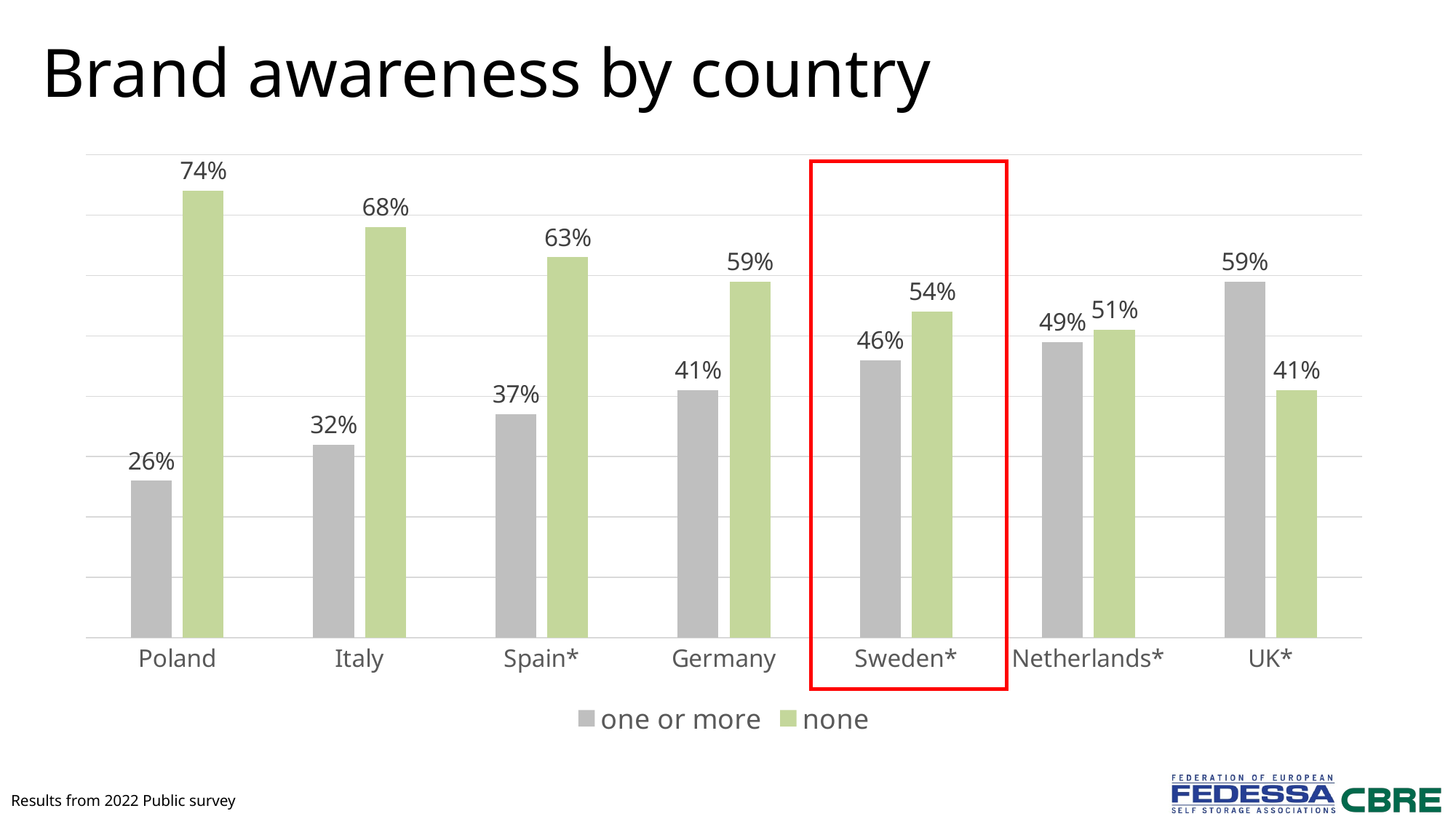
What is the value for 'one or more' in UK*? 59% What is the value for 'one or more' in Poland? 26% Which is larger for the Netherlands*: 'one or more' or 'none'? none How many series does the legend list? 2 What is the difference between the 'none' and 'one or more' values for Germany? 18% What kind of chart is shown on the slide? bar chart Which country has the lowest value for 'one or more'? Poland How many countries are shown on the x axis? 7 Which country is highlighted with a red box? Sweden* What is the value for 'none' in Sweden*? 54% Do the 'one or more' values rise or fall from Poland to UK* along the x axis? rise Which country has the highest value for 'none'? Poland